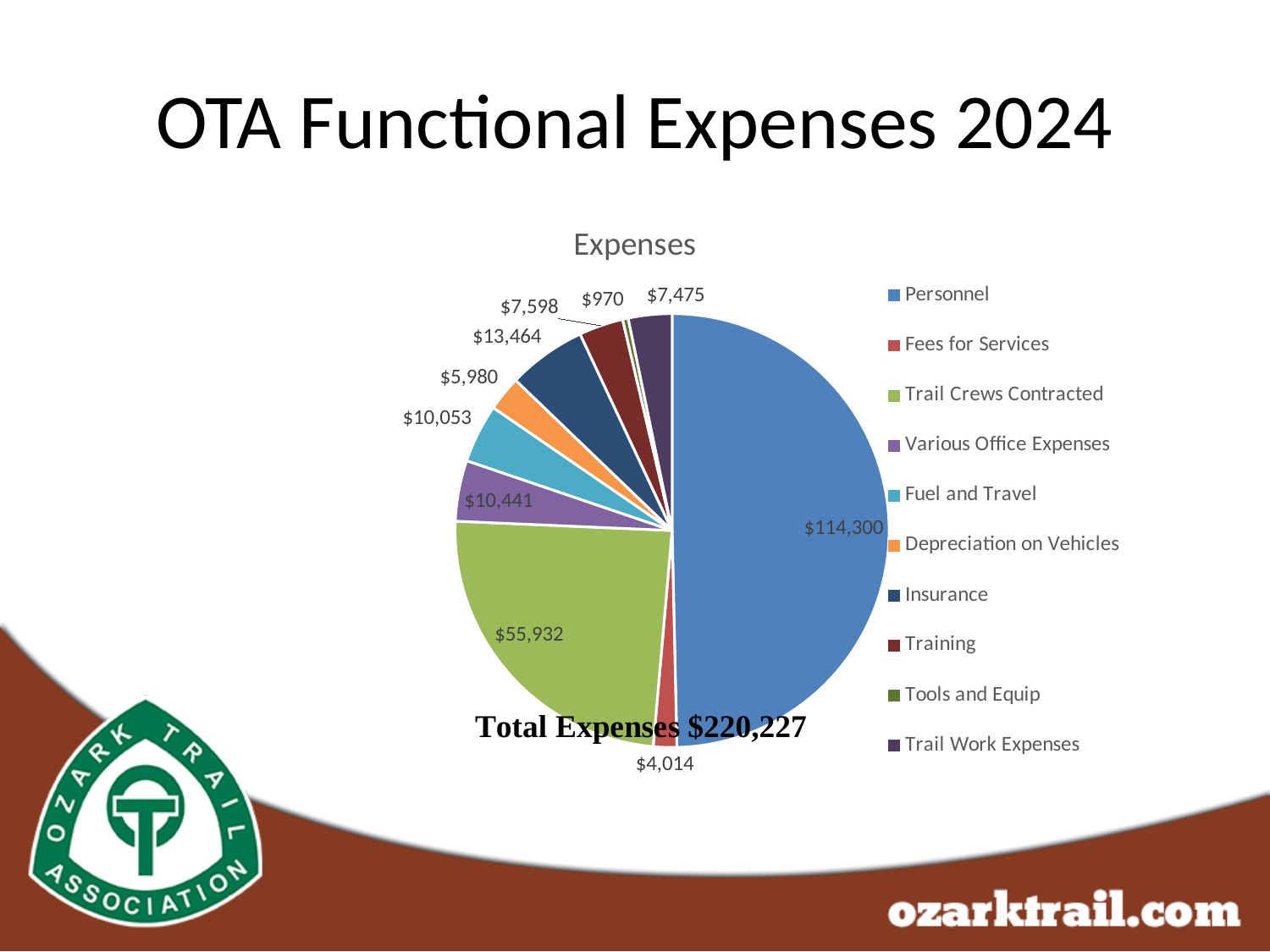
What is the difference between the Insurance and Depreciation on Vehicles values? $7,484 How many categories does the legend of the Expenses pie chart list? 10 What is the difference between the Personnel and Trail Crews Contracted values? $58,368 Which is larger, Insurance or Fuel and Travel? Insurance What is the value for Personnel in the Expenses pie chart? $114,300 Which category has the largest slice in the Expenses pie chart? Personnel Which category has the smallest slice in the Expenses pie chart? Tools and Equip What is the value for Trail Crews Contracted in the Expenses pie chart? $55,932 What is the value for Insurance in the Expenses pie chart? $13,464 What type of chart is shown on the slide? pie chart What is the value for Tools and Equip in the Expenses pie chart? $970 What total expenses figure is printed on the slide? $220,227